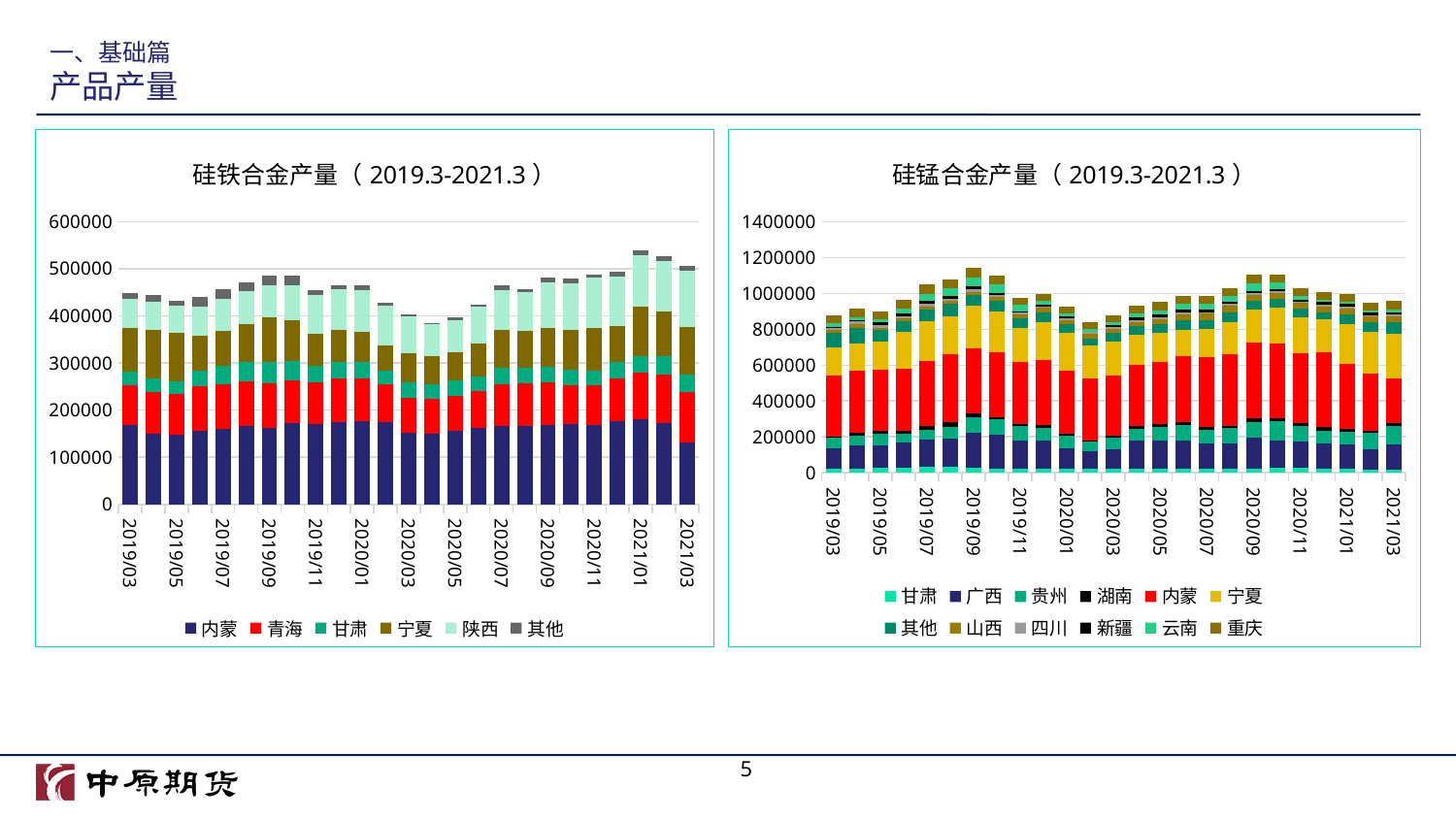
In the 硅锰合金产量 chart, is the total for 2019/09 greater or less than 1000000? greater In the 硅铁合金产量 chart, do the total bars rise or fall from 2020/04 to 2021/01? rise How many monthly bars are plotted in the 硅铁合金产量 chart? 25 What is the title of the chart on the right? 硅锰合金产量（2019.3-2021.3） In the 硅铁合金产量 chart, which month has the tallest total bar? 2021/01 In the 硅铁合金产量 chart, is the total for 2021/01 greater or less than 500000? greater How many series does the legend of the 硅锰合金产量 chart list? 12 In the 硅锰合金产量 chart, is the total for 2020/03 greater or less than 1000000? less In the 硅锰合金产量 chart, which total is larger, 2019/09 or 2020/03? 2019/09 What kind of chart is the 硅铁合金产量 chart on the left? stacked bar chart How many series does the legend of the 硅铁合金产量 chart list? 6